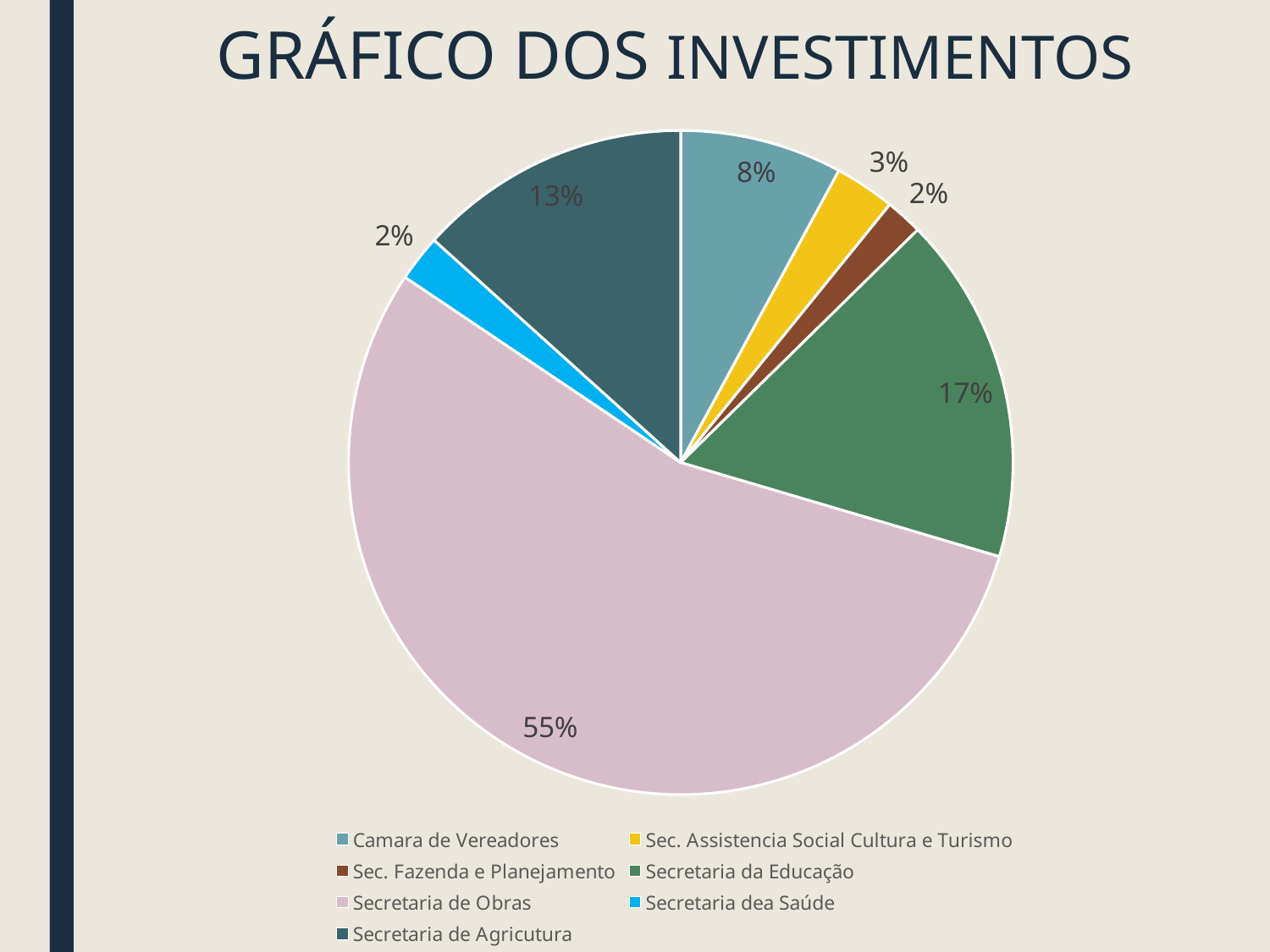
What share of the pie does Secretaria de Obras have? 55% What colour is the slice for Secretaria dea Saúde? light blue What is the difference between the shares of Secretaria de Obras and Secretaria da Educação? 38% What share of the pie does Camara de Vereadores have? 8% What share of the pie does Sec. Assistencia Social Cultura e Turismo have? 3% What kind of chart is shown on the slide? pie chart Which is larger, the share for Secretaria de Agricutura or the share for Camara de Vereadores? Secretaria de Agricutura How many categories does the legend list? 7 What is the title of the chart? GRÁFICO DOS INVESTIMENTOS Which category has the largest slice of the pie? Secretaria de Obras